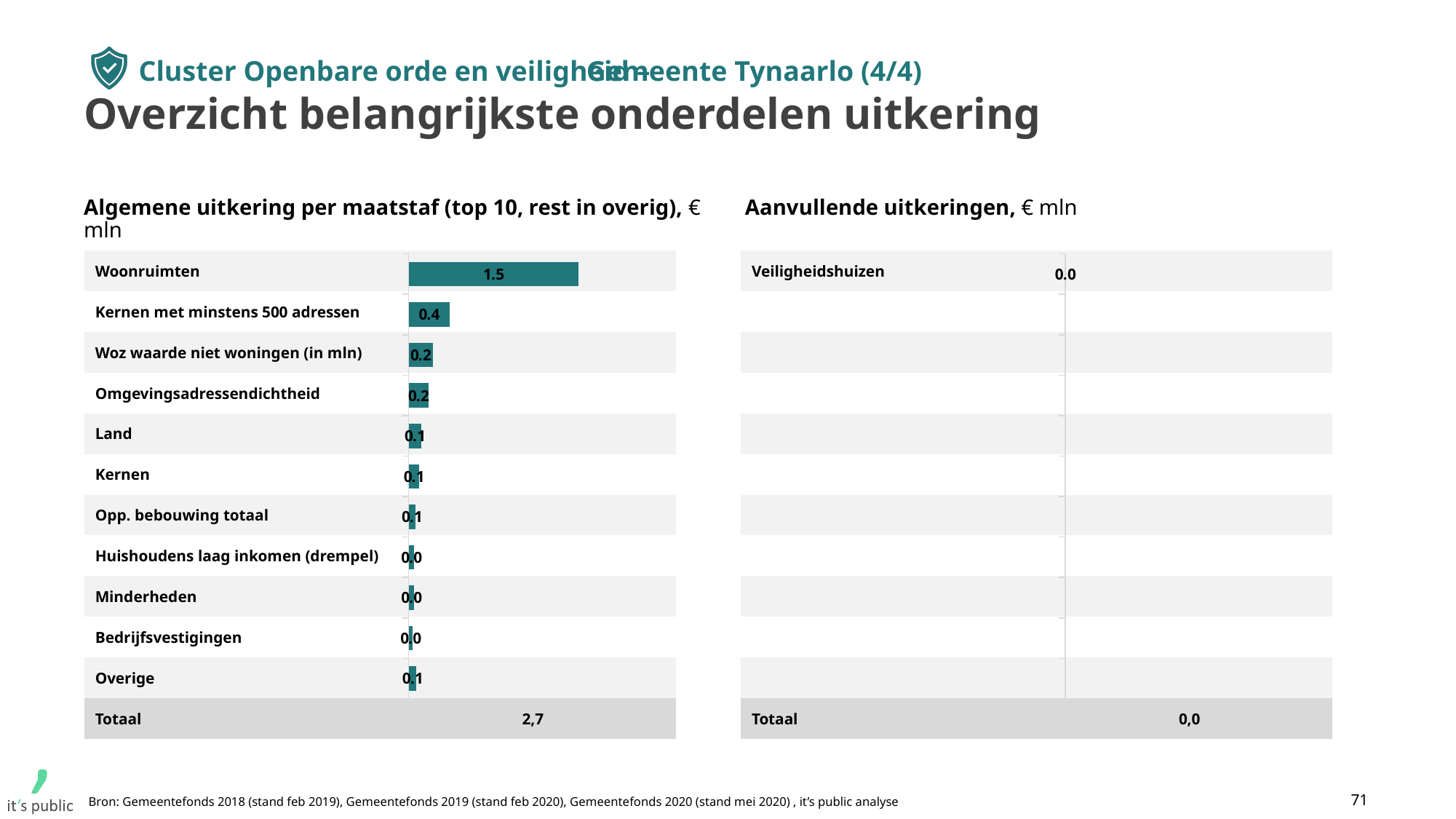
In the chart 'Algemene uitkering per maatstaf', which is larger: the value for Woonruimten or the value for Woz waarde niet woningen (in mln)? Woonruimten What is the Totaal shown below the chart 'Algemene uitkering per maatstaf'? 2,7 In the chart 'Algemene uitkering per maatstaf', what is the value for Omgevingsadressendichtheid? 0.2 In the chart 'Aanvullende uitkeringen', what is the value for Veiligheidshuizen? 0.0 How many categories are shown in the chart 'Aanvullende uitkeringen' (excluding the Totaal row)? 1 What kind of chart is 'Algemene uitkering per maatstaf'? Bar chart In the chart 'Algemene uitkering per maatstaf', what is the difference between the values for Woonruimten and Kernen met minstens 500 adressen? 1.1 In the chart 'Algemene uitkering per maatstaf', what is the value for Kernen met minstens 500 adressen? 0.4 In the chart 'Algemene uitkering per maatstaf', what is the value for Overige? 0.1 In the chart 'Algemene uitkering per maatstaf', which category has the highest value? Woonruimten In the chart 'Algemene uitkering per maatstaf', what is the value for Woonruimten? 1.5 How many categories are shown in the chart 'Algemene uitkering per maatstaf' (excluding the Totaal row)? 11